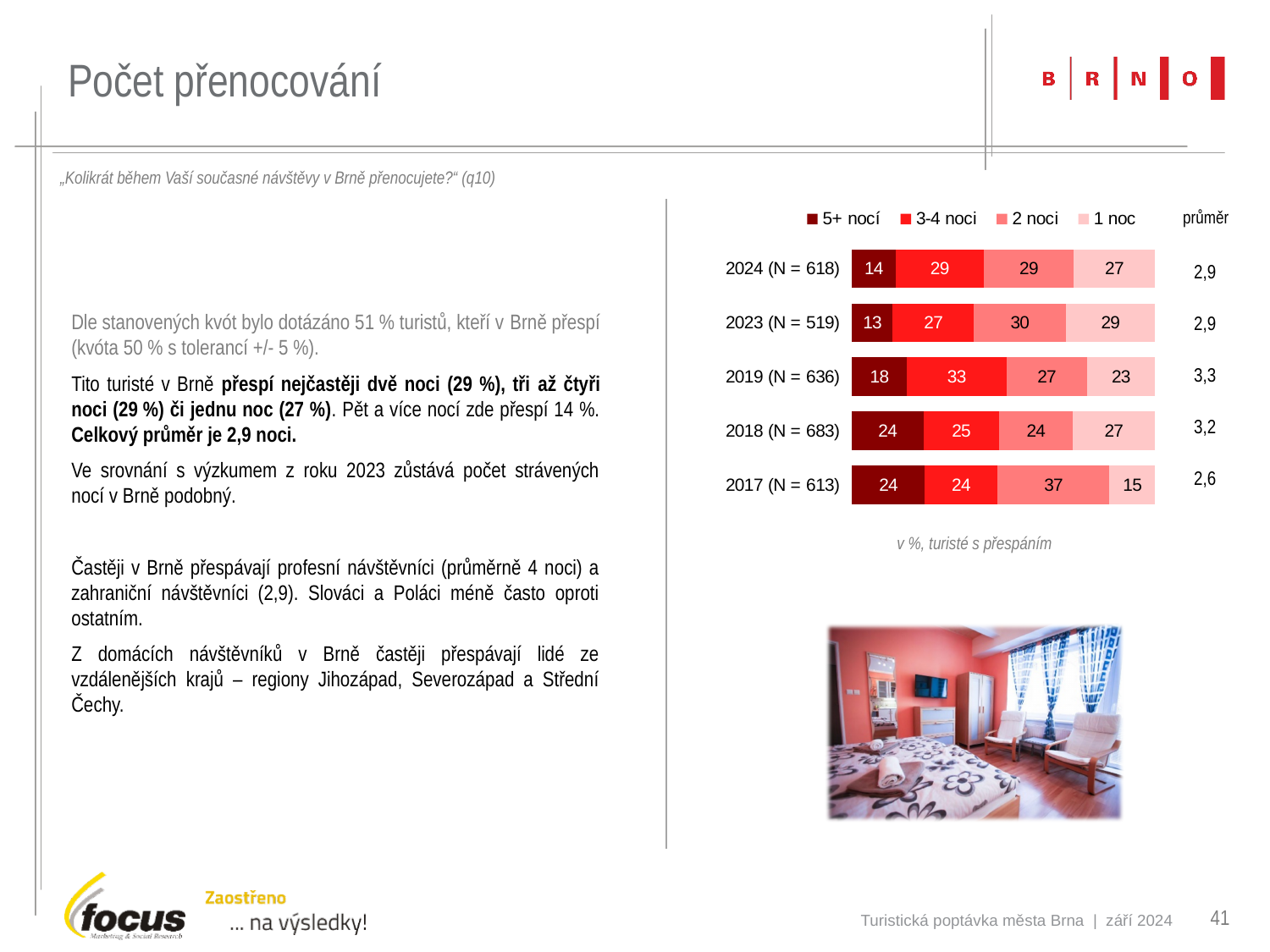
How many series does the chart legend list? 4 Which year has the lowest value for "5+ nocí"? 2023 (N = 519) What is the total of the stacked bar for 2018 (N = 683)? 100 What type of chart is shown on the slide? stacked bar chart What is the value for "5+ nocí" in 2019 (N = 636)? 18 What is the value for "1 noc" in 2017 (N = 613)? 15 Which is larger: the "1 noc" value in 2023 (N = 519) or in 2019 (N = 636)? 2023 (N = 519) How many year categories are plotted in the chart? 5 Which year has the highest value for "2 noci"? 2017 (N = 613) What is the average (průměr) shown for 2019 (N = 636)? 3,3 What is the value for "2 noci" in 2024 (N = 618)? 29 What is the difference between the "3-4 noci" value in 2019 (N = 636) and in 2024 (N = 618)? 4